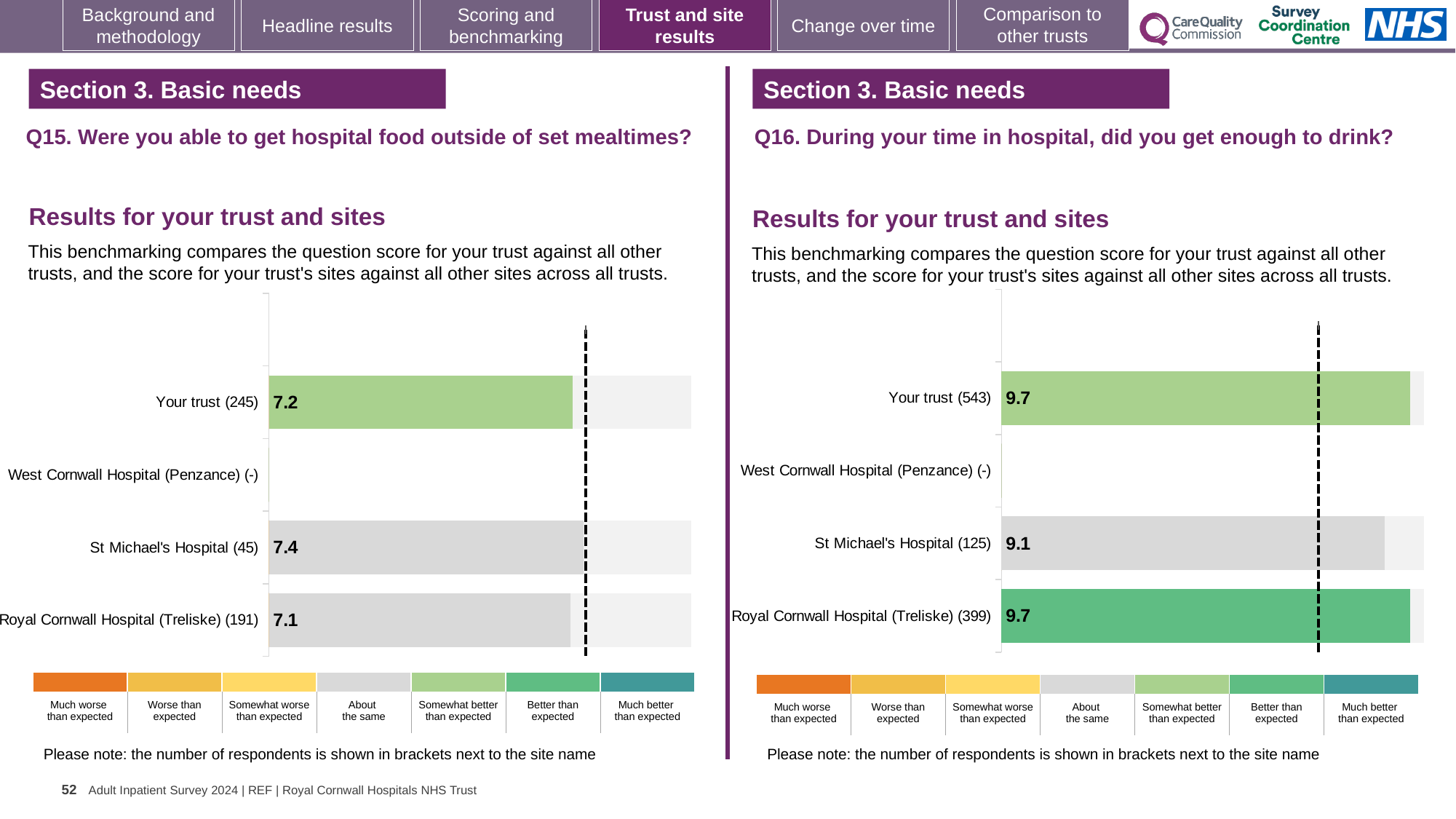
In the Q16 chart (right), what is the score for Your trust? 9.7 In the Q16 chart (right), how many respondents are shown in brackets for Your trust? 543 In the Q15 chart (left), what is the score for Royal Cornwall Hospital (Treliske)? 7.1 In the Q16 chart (right), which site has the lowest score? St Michael's Hospital In the Q16 chart (right), what is the score for Royal Cornwall Hospital (Treliske)? 9.7 In the Q15 chart (left), what is the score for Your trust? 7.2 In the Q16 chart (right), what is the difference between the scores for Your trust and St Michael's Hospital? 0.6 In the Q15 chart (left), what is the score for St Michael's Hospital? 7.4 In the Q15 chart (left), which site has the highest score? St Michael's Hospital What kind of chart is used for the Q15 results on the left? Bar chart In the Q16 chart (right), what is the score for St Michael's Hospital? 9.1 In the Q15 chart (left), what is the difference between the scores for St Michael's Hospital and Royal Cornwall Hospital (Treliske)? 0.3